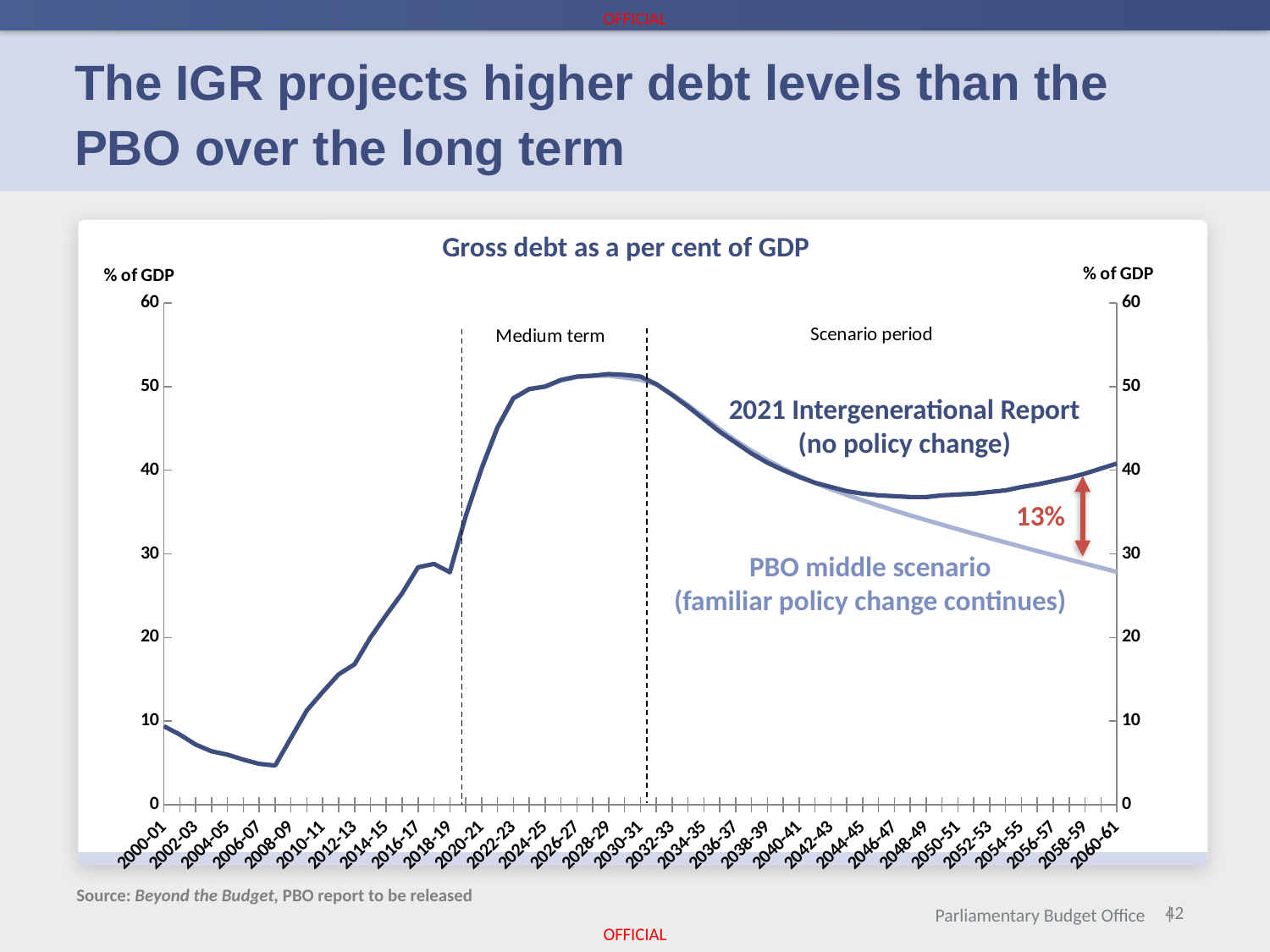
Is the 2021 Intergenerational Report value for 2048-49 greater or less than 40? less What kind of chart is shown on the slide? Line chart Is the PBO middle scenario value for 2060-61 greater or less than 30? less Is the gross debt value for 2012-13 greater or less than 20? less Which year has the lowest gross debt as a per cent of GDP on the chart? 2007-08 In 2060-61, which series shows the higher gross debt: the 2021 Intergenerational Report or the PBO middle scenario? 2021 Intergenerational Report What is the title of the chart? Gross debt as a per cent of GDP What is the labelled gap between the 2021 Intergenerational Report line and the PBO middle scenario line at the end of the projection? 13% Does the PBO middle scenario line rise or fall from 2032-33 to 2060-61? Fall How many series are plotted on the chart? 2